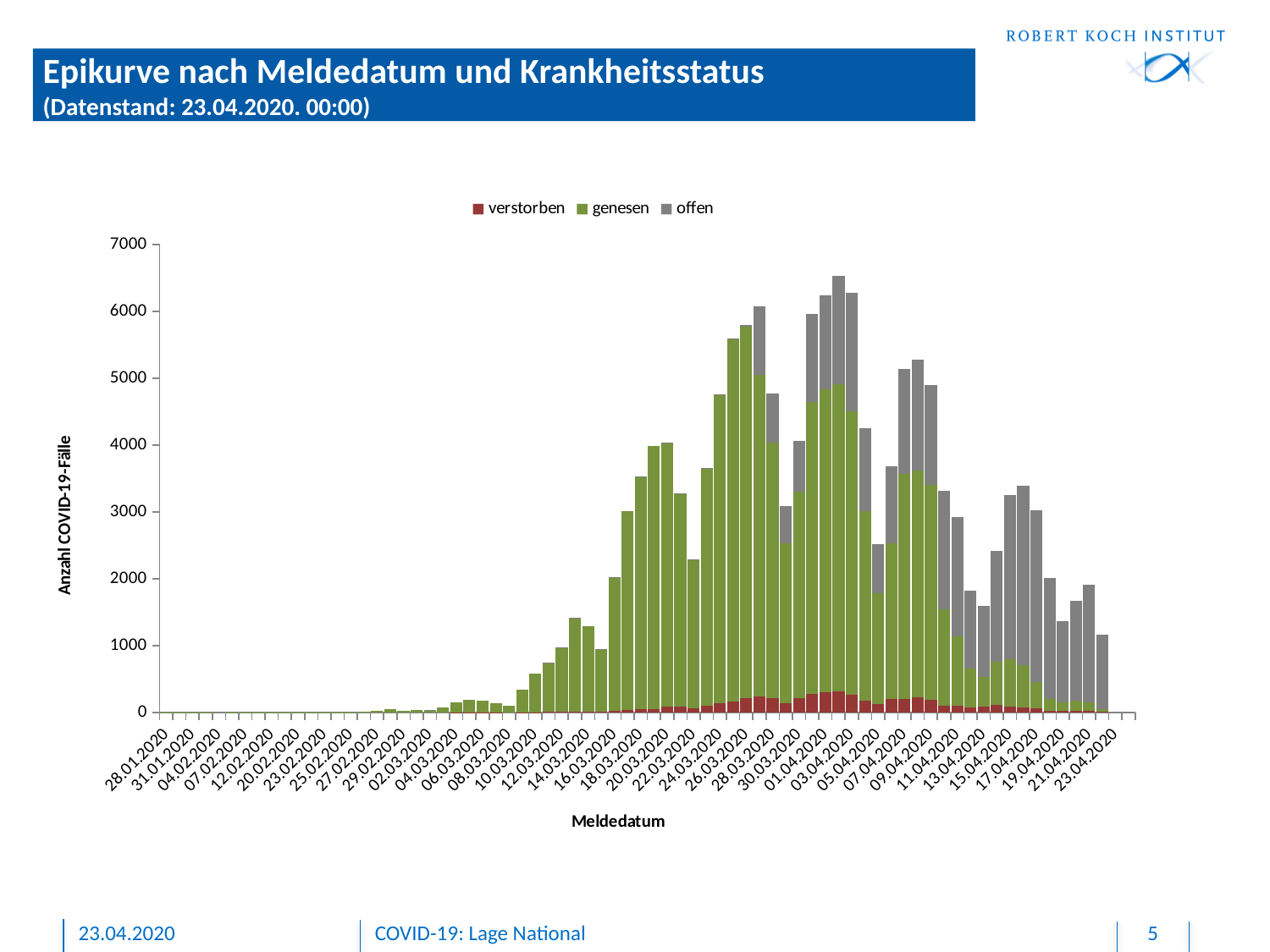
Is the total value for 20.03.2020 greater or less than 3000? greater Do the total values generally rise or fall from 28.01.2020 to 28.03.2020? rise Is the total value for 23.04.2020 greater or less than 2000? less How many series does the legend list? 3 What kind of chart is shown on the slide? stacked bar chart Which date has the larger total, 28.03.2020 or 16.03.2020? 28.03.2020 Is the total value for 13.04.2020 greater or less than 4000? less What is the title of the chart on the slide? Epikurve nach Meldedatum und Krankheitsstatus Which date has the larger total, 20.03.2020 or 23.04.2020? 20.03.2020 What are the three series named in the legend? verstorben, genesen, offen